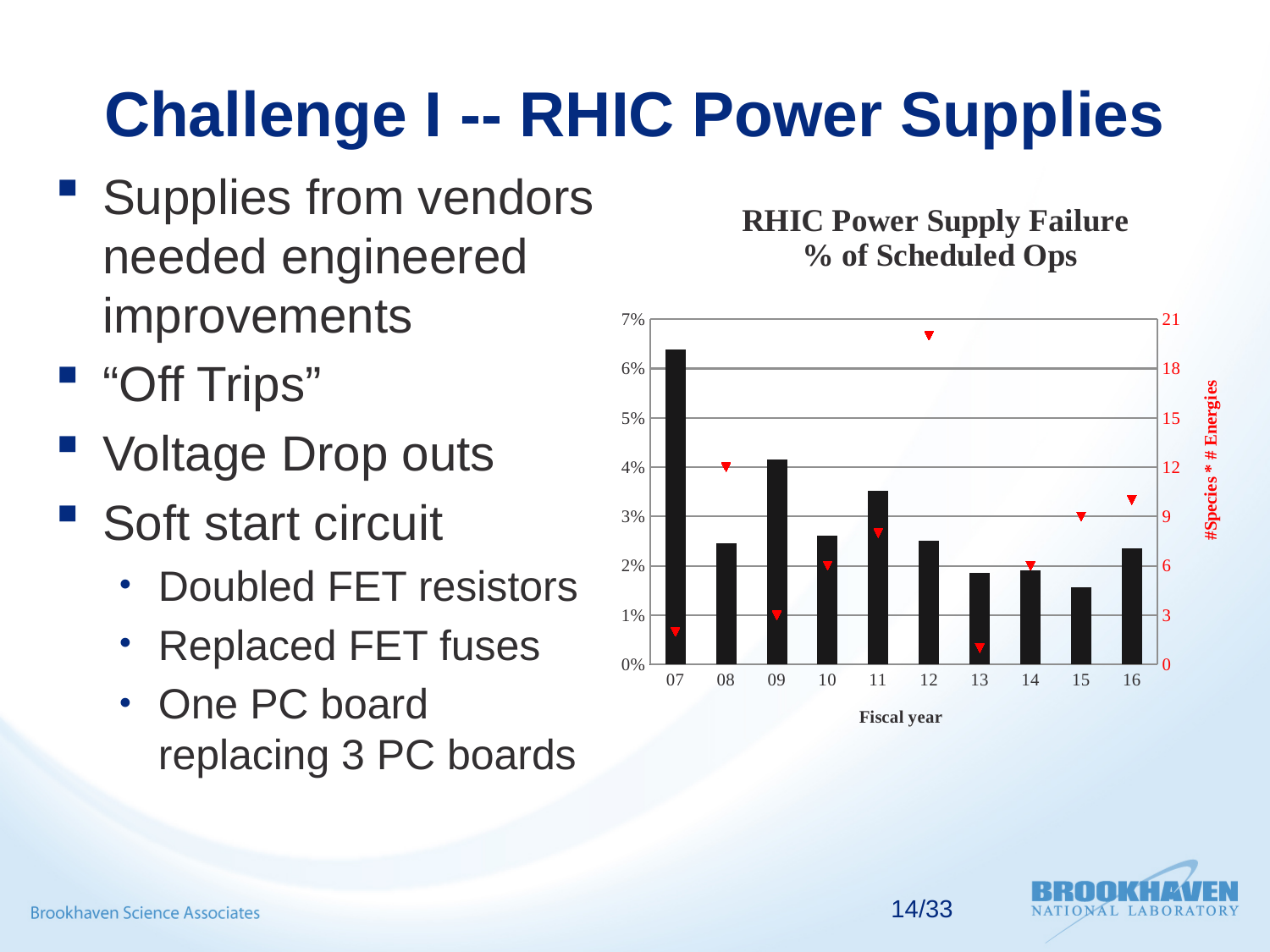
Is the failure percentage bar for fiscal year 09 greater or less than 4%? greater Which fiscal year has the lowest power supply failure percentage bar? 15 Is the failure percentage bar for fiscal year 13 greater or less than 2%? less Is the red triangle marker for fiscal year 08 greater or less than 9 on the right axis? greater Which fiscal year has the highest red triangle marker (#Species * # Energies)? 12 What kind of chart is shown on the slide? bar chart What is the label of the x axis of the chart? Fiscal year What is the title of the chart? RHIC Power Supply Failure % of Scheduled Ops Which fiscal year has the highest power supply failure percentage bar? 07 How many fiscal years are shown on the x axis of the chart? 10 Which fiscal year has a higher failure percentage bar, 11 or 16? 11